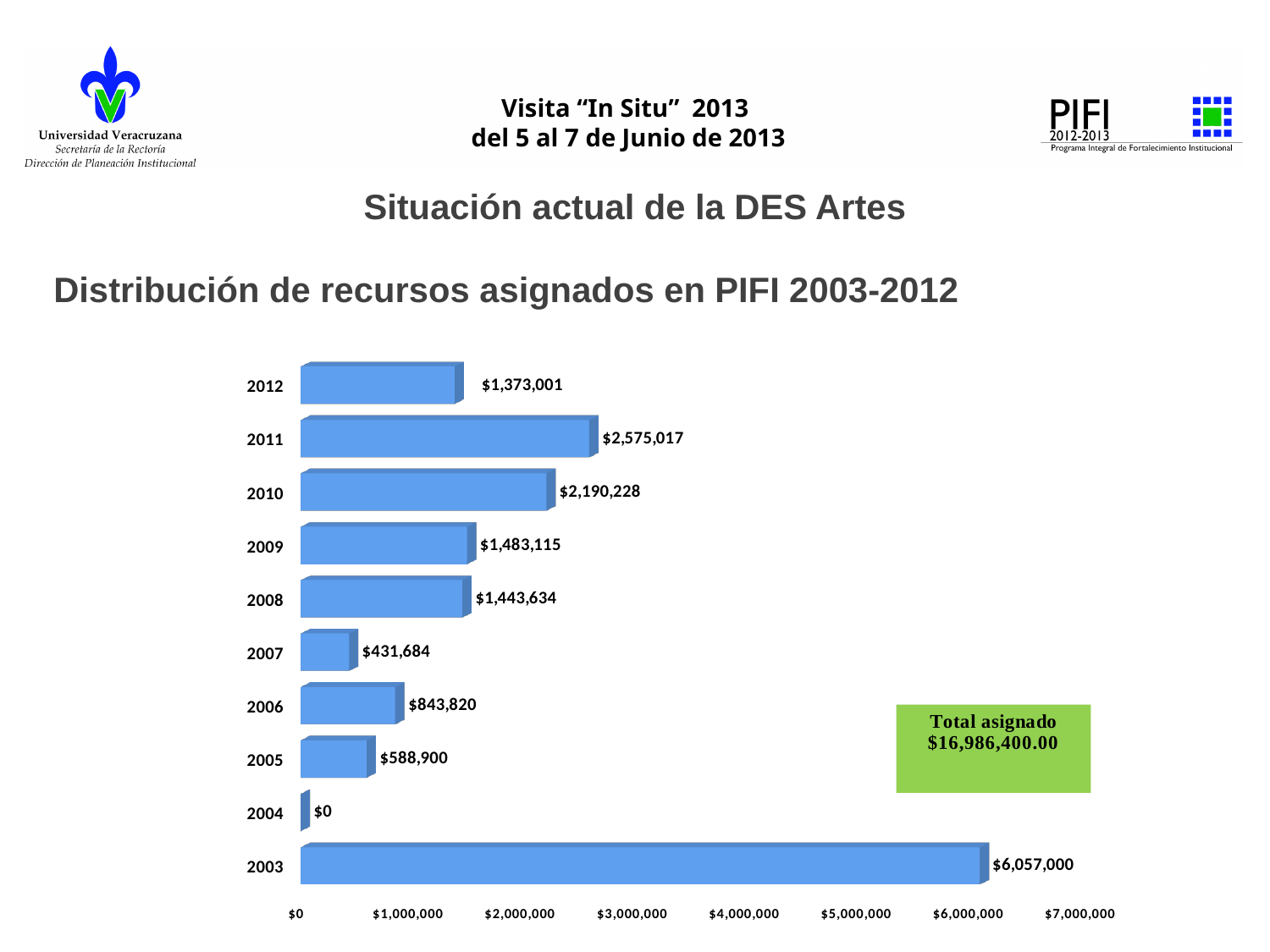
What value is shown for 2007? $431,684 Is the value for 2011 greater or less than $2,000,000? greater What total assigned amount (Total asignado) is shown in the box next to the chart? $16,986,400.00 Which year has the lowest value? 2004 What kind of chart is shown on the slide? bar chart What value is shown for 2003? $6,057,000 From 2008 to 2011, do the values rise or fall? rise What is the difference between the values for 2011 and 2010? $384,789 What value is shown for 2011? $2,575,017 Which year has the highest value? 2003 Which is larger, the value for 2006 or the value for 2005? 2006 How many years are shown in the chart? 10